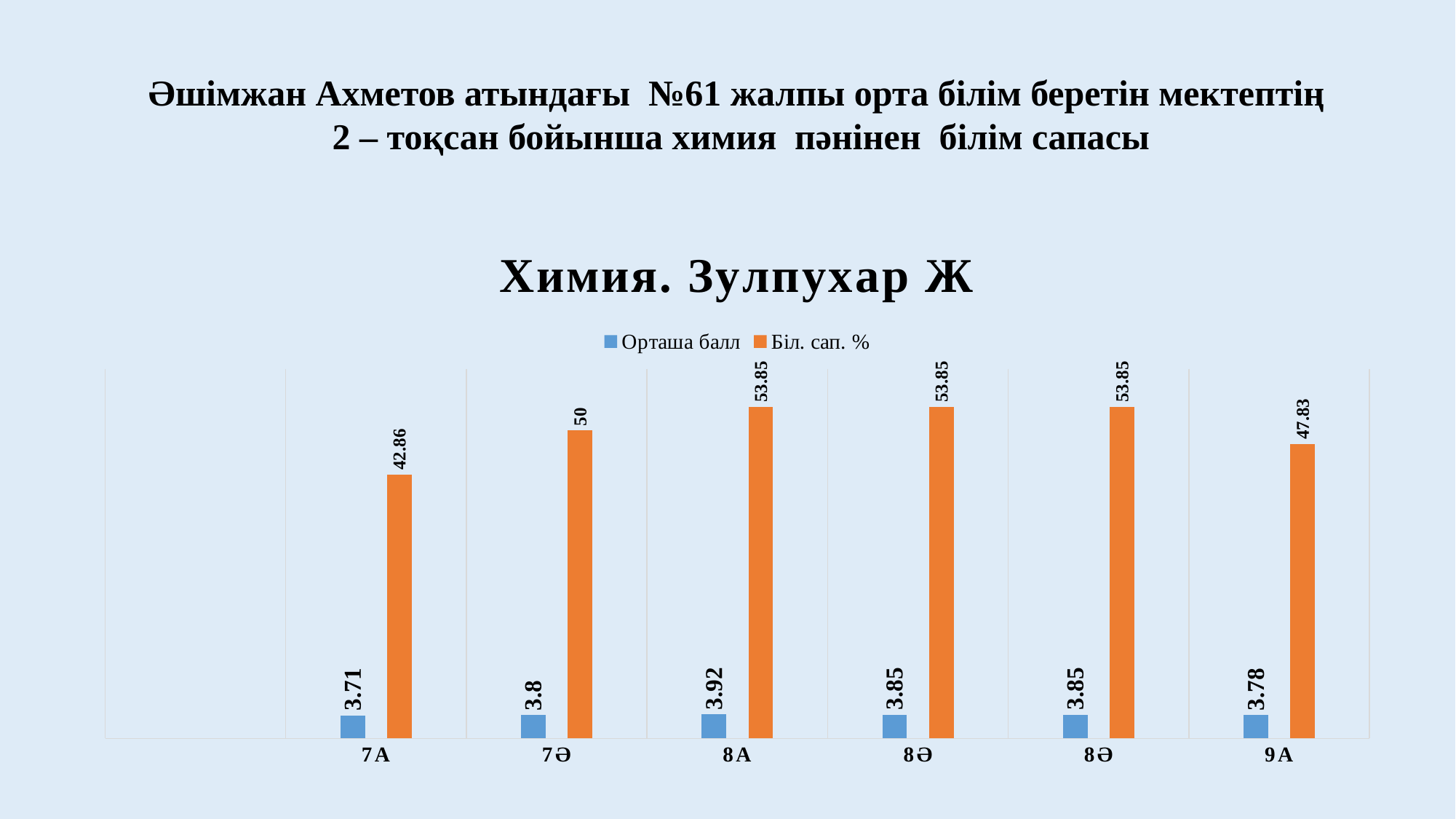
What is the Орташа балл value for 8А? 3.92 What is the title of the chart? Химия. Зулпухар Ж What is the difference between the Біл. сап. % values for 8А and 7А? 10.99 What is the Біл. сап. % value for 7Ә? 50 Which is larger, the Біл. сап. % value for 7Ә or for 9А? 7Ә What is the Орташа балл value for 7А? 3.71 How many series does the legend list? 2 What kind of chart is shown? Bar chart How many classes are shown on the x axis? 6 Which class has the lowest Біл. сап. % value? 7А Which class has the highest Орташа балл? 8А What is the Біл. сап. % value for 9А? 47.83